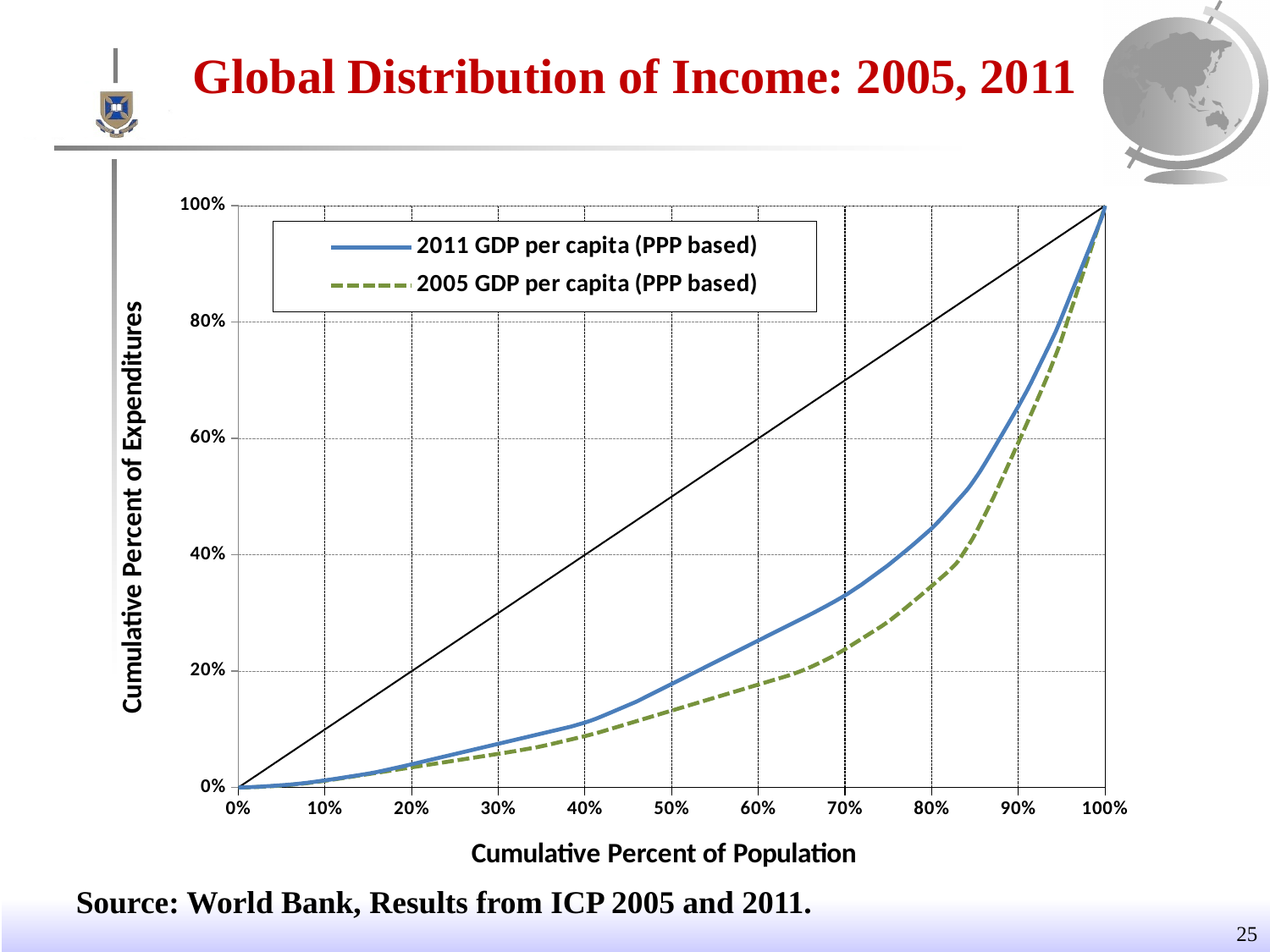
What is the label of the vertical axis? Cumulative Percent of Expenditures What is the cumulative percent of expenditures for the 2005 GDP per capita (PPP based) series at 0% cumulative percent of population? 0% At 80% cumulative percent of population, which series has the higher cumulative percent of expenditures, 2011 GDP per capita (PPP based) or 2005 GDP per capita (PPP based)? 2011 GDP per capita (PPP based) What is the title of the chart on the slide? Global Distribution of Income: 2005, 2011 What kind of chart is shown on the slide? line chart How many series does the legend list? 2 Is the value for the 2005 GDP per capita (PPP based) series at 80% cumulative percent of population greater or less than 40%? less Is the value for the 2011 GDP per capita (PPP based) series at 70% cumulative percent of population greater or less than 40%? less Do the values of the 2011 GDP per capita (PPP based) series rise or fall as the cumulative percent of population increases? rise Is the value for the 2011 GDP per capita (PPP based) series at 90% cumulative percent of population greater or less than 60%? greater What is the cumulative percent of expenditures for the 2011 GDP per capita (PPP based) series at 100% cumulative percent of population? 100%